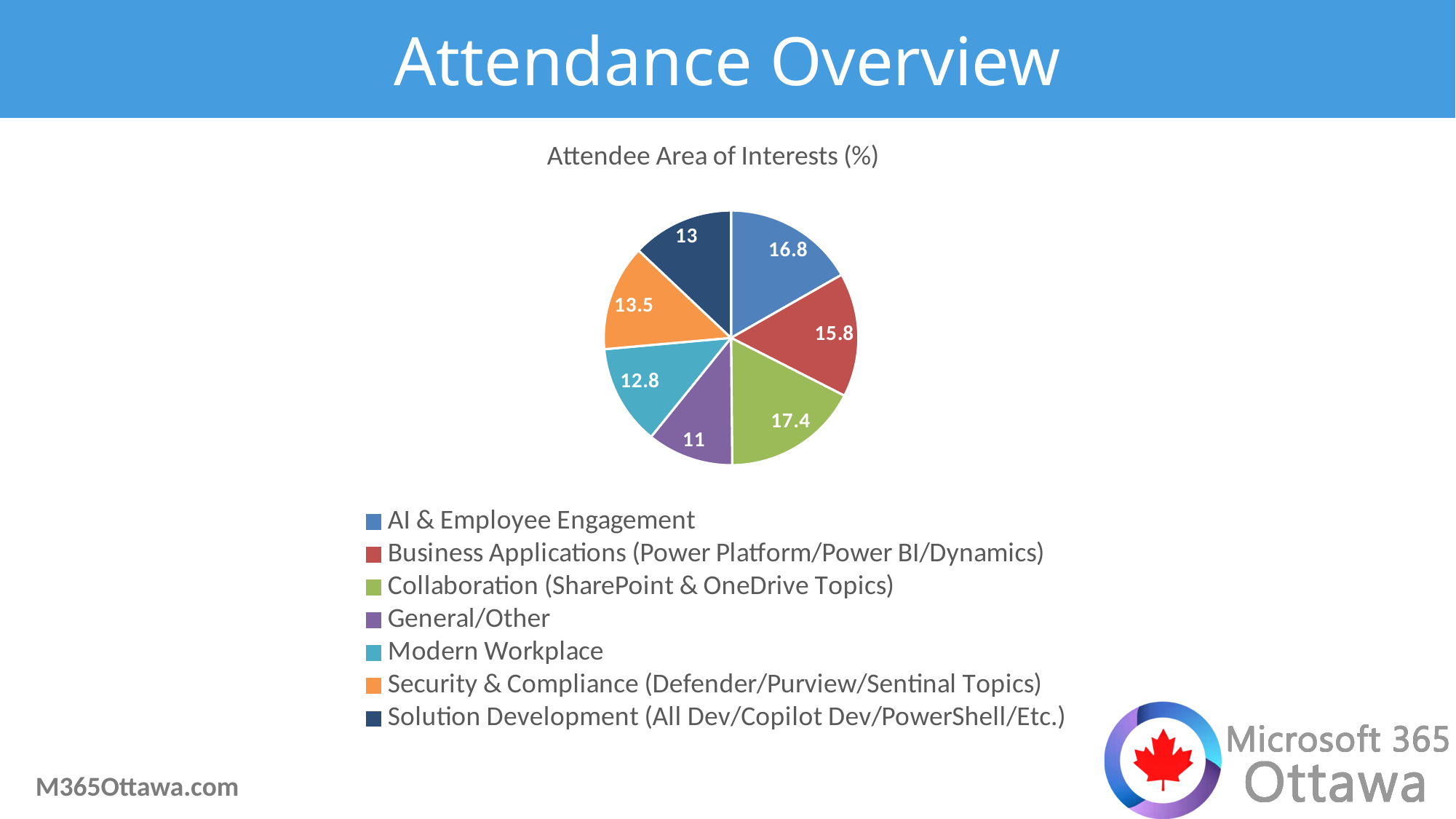
What is the value for Business Applications (Power Platform/Power BI/Dynamics)? 15.8 Which is larger, the value for Security & Compliance (Defender/Purview/Sentinal Topics) or the value for Modern Workplace? Security & Compliance (Defender/Purview/Sentinal Topics) What colour is the slice for General/Other? purple What is the difference between the values for Collaboration (SharePoint & OneDrive Topics) and General/Other? 6.4 What is the value for Solution Development (All Dev/Copilot Dev/PowerShell/Etc.)? 13 What is the value for AI & Employee Engagement? 16.8 What is the title of the chart? Attendee Area of Interests (%) How many categories does the pie chart have? 7 Which category has the largest slice of the pie? Collaboration (SharePoint & OneDrive Topics) Which category has the smallest slice of the pie? General/Other What type of chart is shown on the slide? pie chart What is the value for Modern Workplace? 12.8